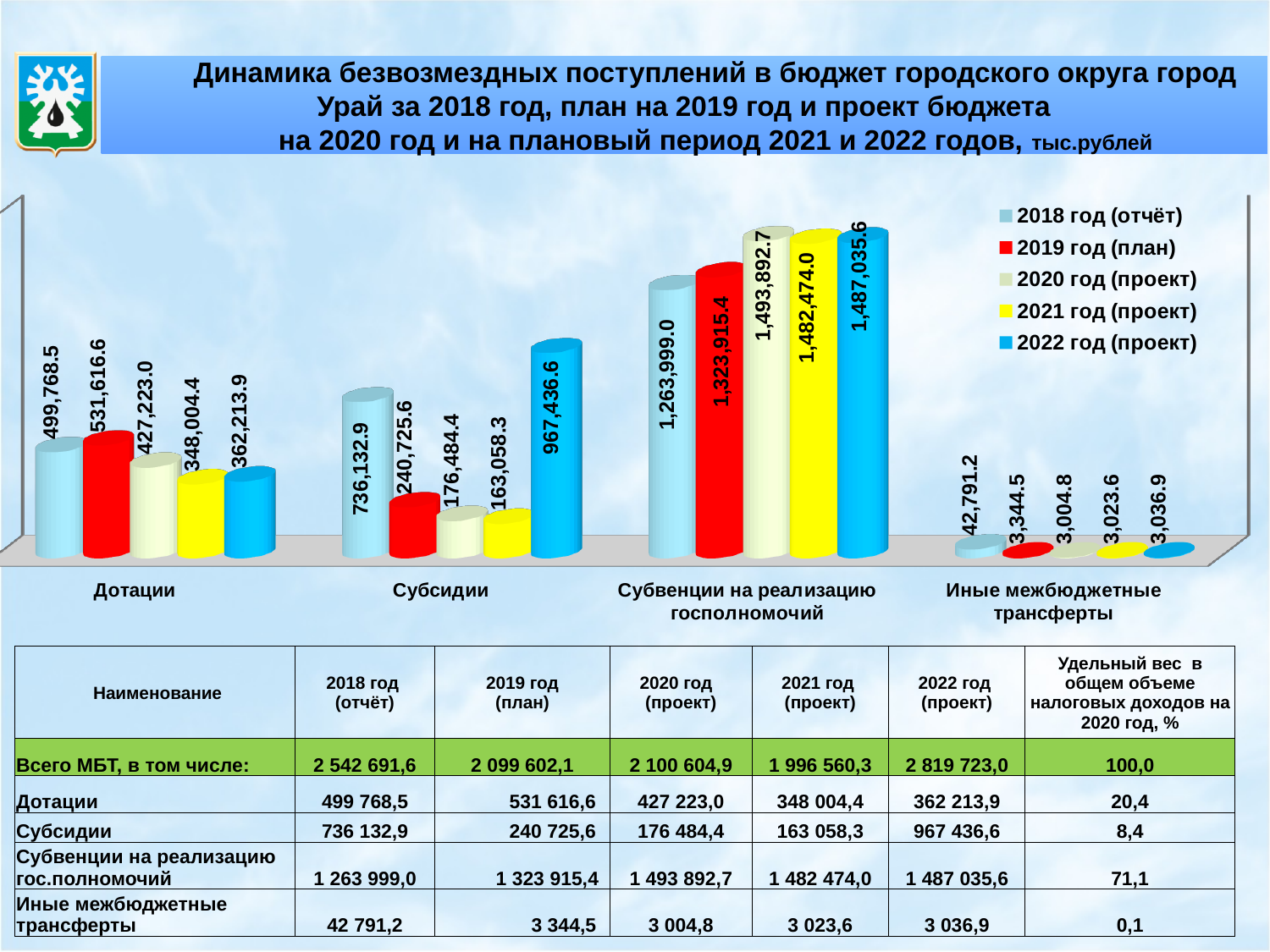
How many series does the chart legend list? 5 Which is larger for Дотации: the 2019 год (план) value or the 2018 год (отчёт) value? 2019 год (план) What is the value for Иные межбюджетные трансферты in the 2021 год (проект) series? 3,023.6 What is the value for Субсидии in the 2022 год (проект) series? 967,436.6 What is the difference between the 2022 год (проект) and 2021 год (проект) values for Субсидии? 804,378.3 What is the value for Субвенции на реализацию госполномочий in the 2019 год (план) series? 1,323,915.4 What is the value for Дотации in the 2018 год (отчёт) series? 499,768.5 Which year series has the lowest value for Дотации? 2021 год (проект) Which colour represents the 2022 год (проект) series in the chart? Blue How many categories are shown on the x axis of the chart? 4 Which year series has the highest value for Субвенции на реализацию госполномочий? 2020 год (проект) What kind of chart is shown on the slide? Bar chart